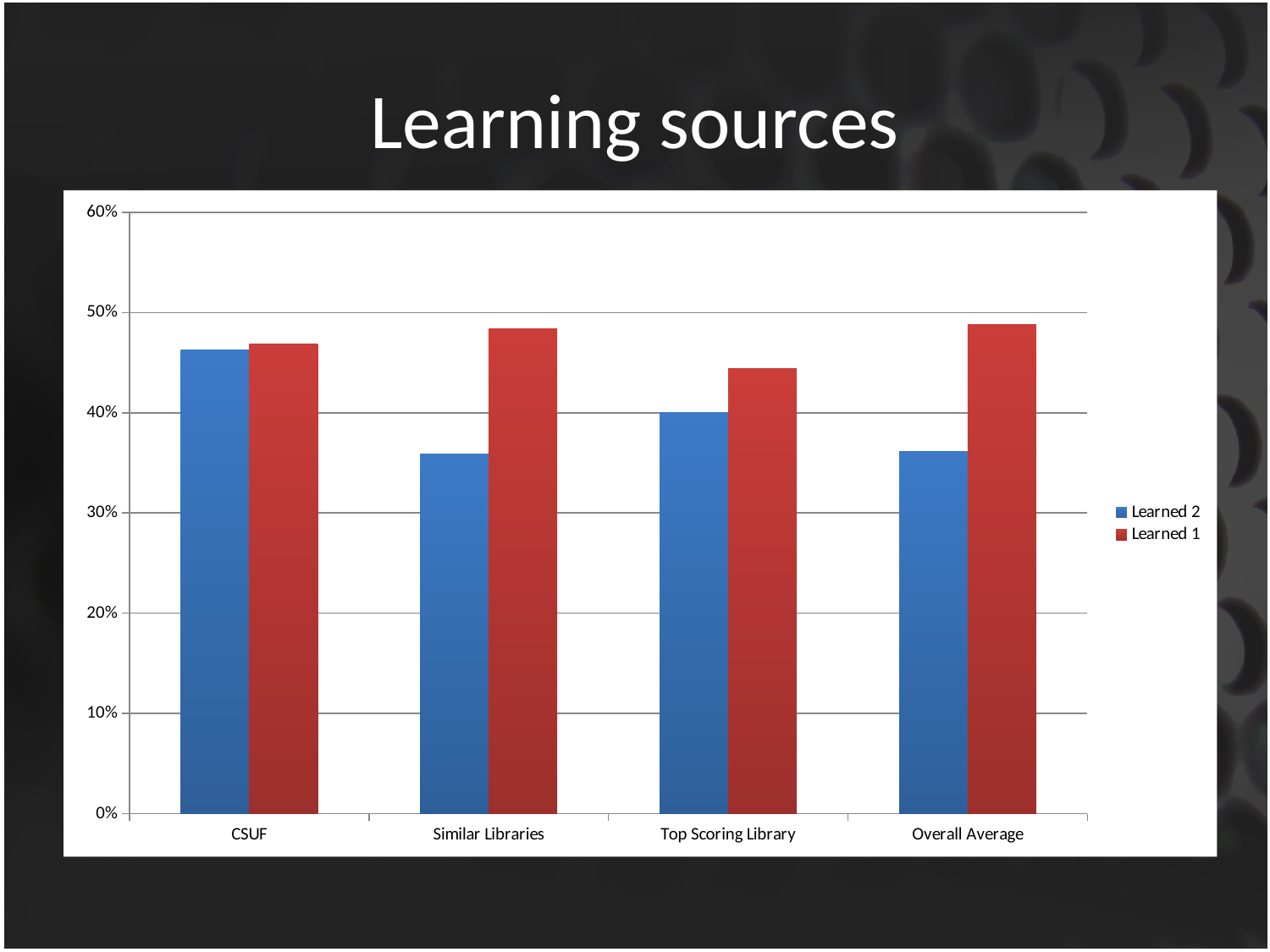
What is the title of the chart on the slide? Learning sources Is the Learned 1 value for Overall Average greater or less than 40%? greater How many series does the chart's legend list? 2 How many categories are shown on the x axis of the chart? 4 What kind of chart is shown on the slide? bar chart Which series is shown in red in the chart? Learned 1 Is the Learned 2 value for CSUF greater or less than 40%? greater Is the Learned 2 value for Similar Libraries greater or less than 40%? less Which category has the lowest value for the Learned 1 series? Top Scoring Library For Similar Libraries, which series has the larger value, Learned 1 or Learned 2? Learned 1 For Top Scoring Library, which series has the larger value, Learned 1 or Learned 2? Learned 1 Which category has the highest value for the Learned 2 series? CSUF